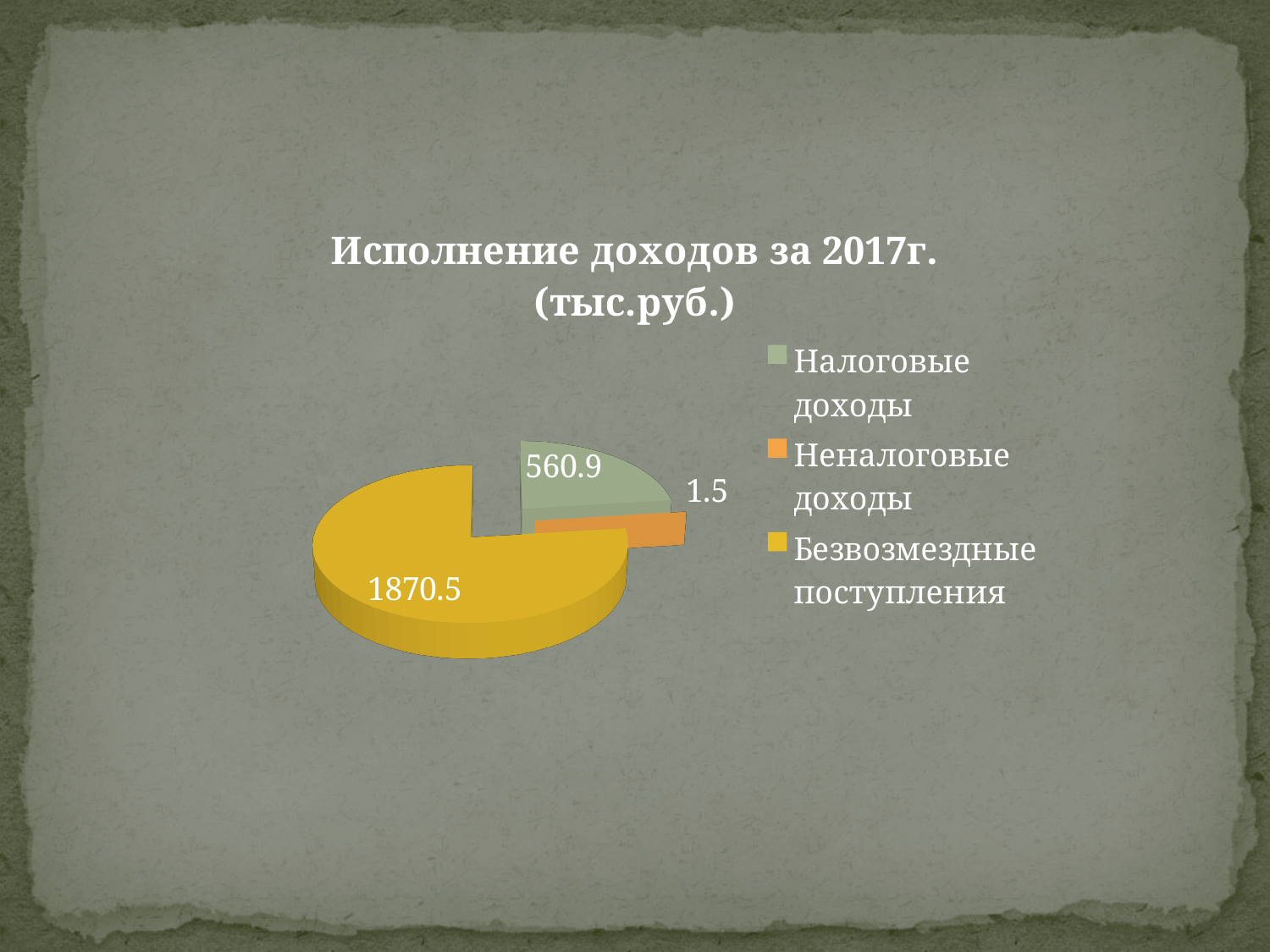
What type of chart is shown on the slide? Pie chart What colour is the slice for Безвозмездные поступления? Yellow What is the value for Неналоговые доходы? 1.5 What is the chart's title? Исполнение доходов за 2017г. (тыс.руб.) What is the value for Налоговые доходы? 560.9 Which is larger, the value for Налоговые доходы or the value for Неналоговые доходы? Налоговые доходы What is the difference between the values for Безвозмездные поступления and Налоговые доходы? 1309.6 Which category has the largest slice of the pie? Безвозмездные поступления What is the total of all three slices? 2432.9 What is the value for Безвозмездные поступления? 1870.5 Which category has the smallest slice of the pie? Неналоговые доходы How many categories does the legend list? 3